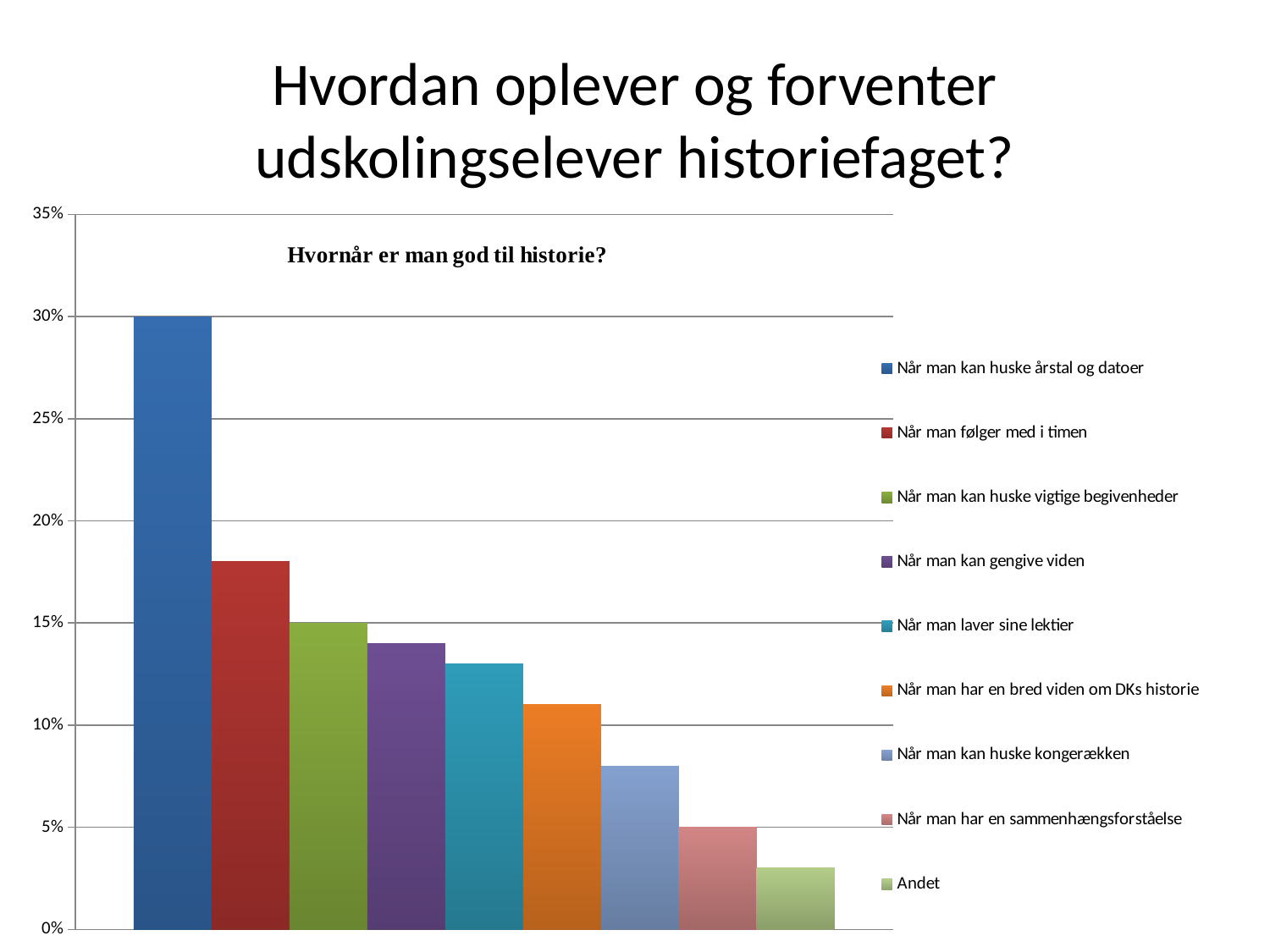
What is the value for 'Når man kan huske vigtige begivenheder'? 15% How many series does the legend list? 9 How many bars are plotted in the chart? 9 What kind of chart is shown on the slide? bar chart Is the value for 'Når man følger med i timen' greater or less than 20%? less Is the value for 'Når man har en bred viden om DKs historie' greater or less than 10%? greater Which series has the lowest value? Andet What is the title of the chart? Hvornår er man god til historie? Which is larger, the value for 'Når man laver sine lektier' or the value for 'Når man kan huske kongerækken'? Når man laver sine lektier What is the value for 'Når man kan huske årstal og datoer'? 30% Which series has the highest value? Når man kan huske årstal og datoer What is the value for 'Når man har en sammenhængsforståelse'? 5%